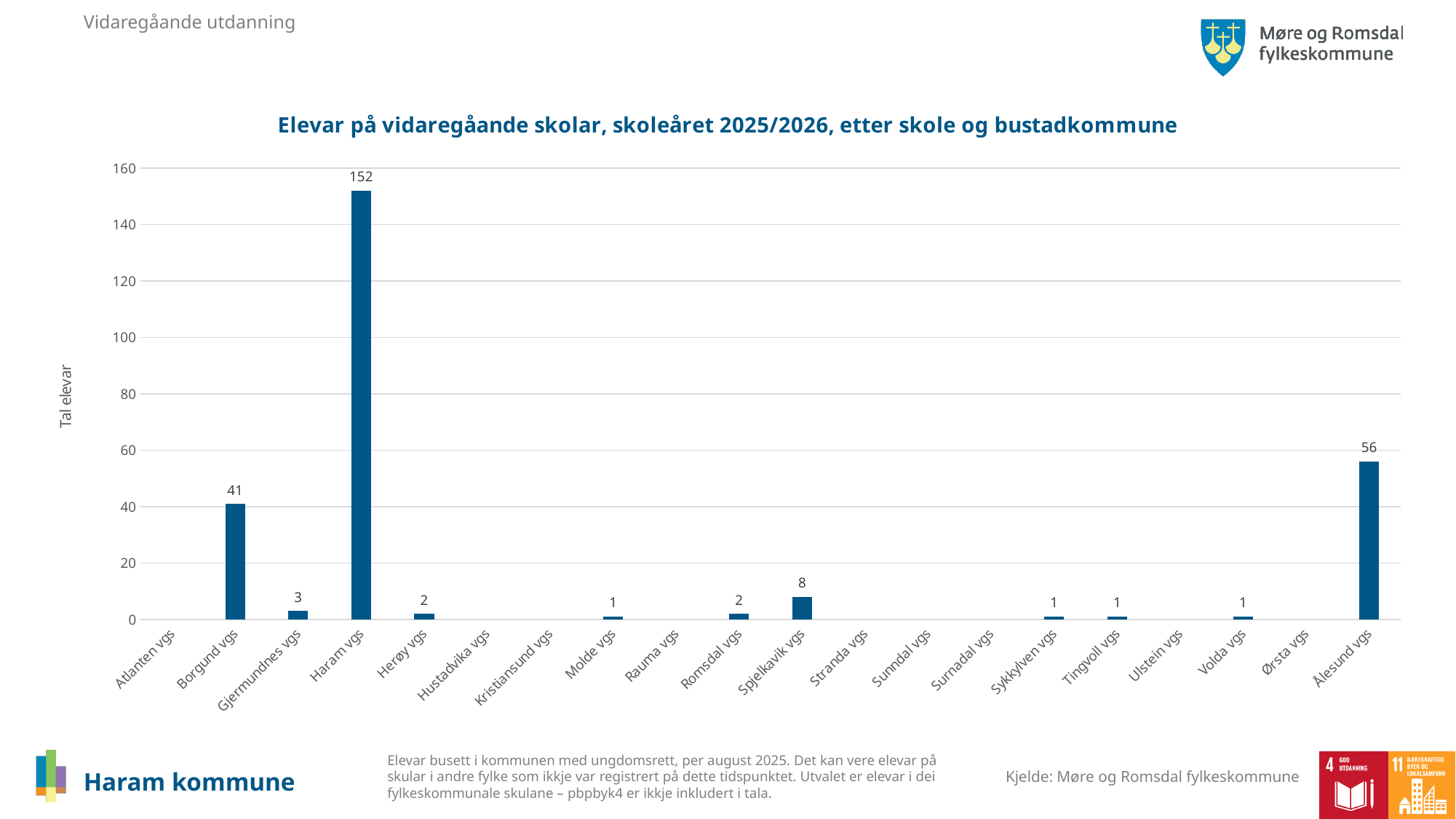
What is the difference between the values for Haram vgs and Ålesund vgs? 96 How many schools are shown on the x axis? 20 Which school has the highest number of students? Haram vgs What is the value for Haram vgs? 152 What is the value for Ålesund vgs? 56 What is the value for Gjermundnes vgs? 3 Which is larger, the value for Borgund vgs or the value for Spjelkavik vgs? Borgund vgs What kind of chart is shown on the slide? Bar chart Is the value for Haram vgs greater or less than 140? greater What is the value for Borgund vgs? 41 What is the value for Spjelkavik vgs? 8 What is the difference between the values for Ålesund vgs and Borgund vgs? 15